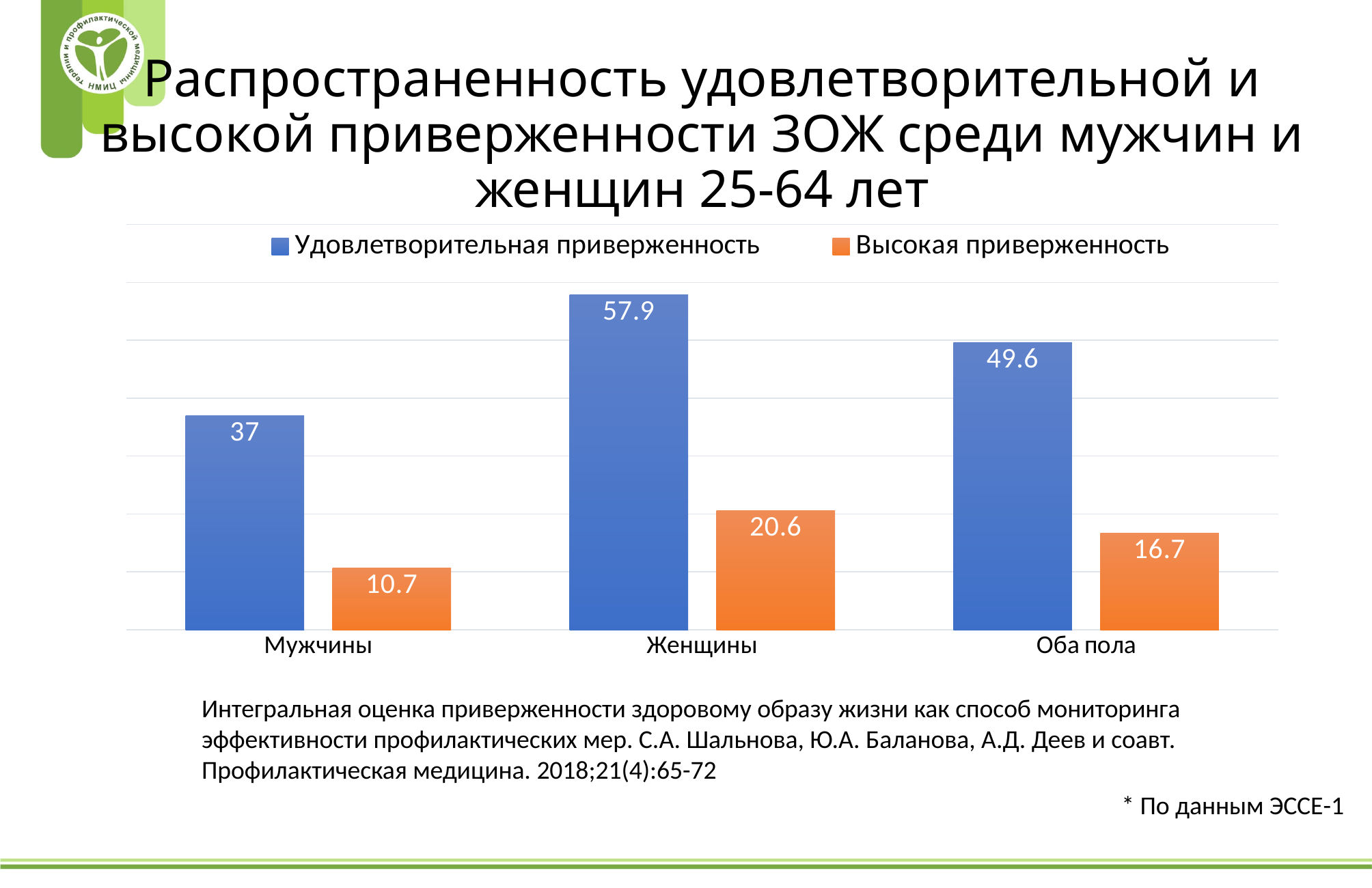
Which is larger: Высокая приверженность for Женщины or for Оба пола? Женщины What is the value of Удовлетворительная приверженность for Оба пола? 49.6 How many series does the legend list? 2 Which category has the lowest value for Высокая приверженность? Мужчины How many categories are shown on the x axis? 3 What is the difference between Удовлетворительная приверженность for Женщины and for Мужчины? 20.9 Which category has the highest value for Удовлетворительная приверженность? Женщины What is the value of Высокая приверженность for Женщины? 20.6 What kind of chart is shown on the slide? Bar chart What is the value of Высокая приверженность for Мужчины? 10.7 What is the difference between Удовлетворительная приверженность and Высокая приверженность for Оба пола? 32.9 What is the value of Удовлетворительная приверженность for Мужчины? 37